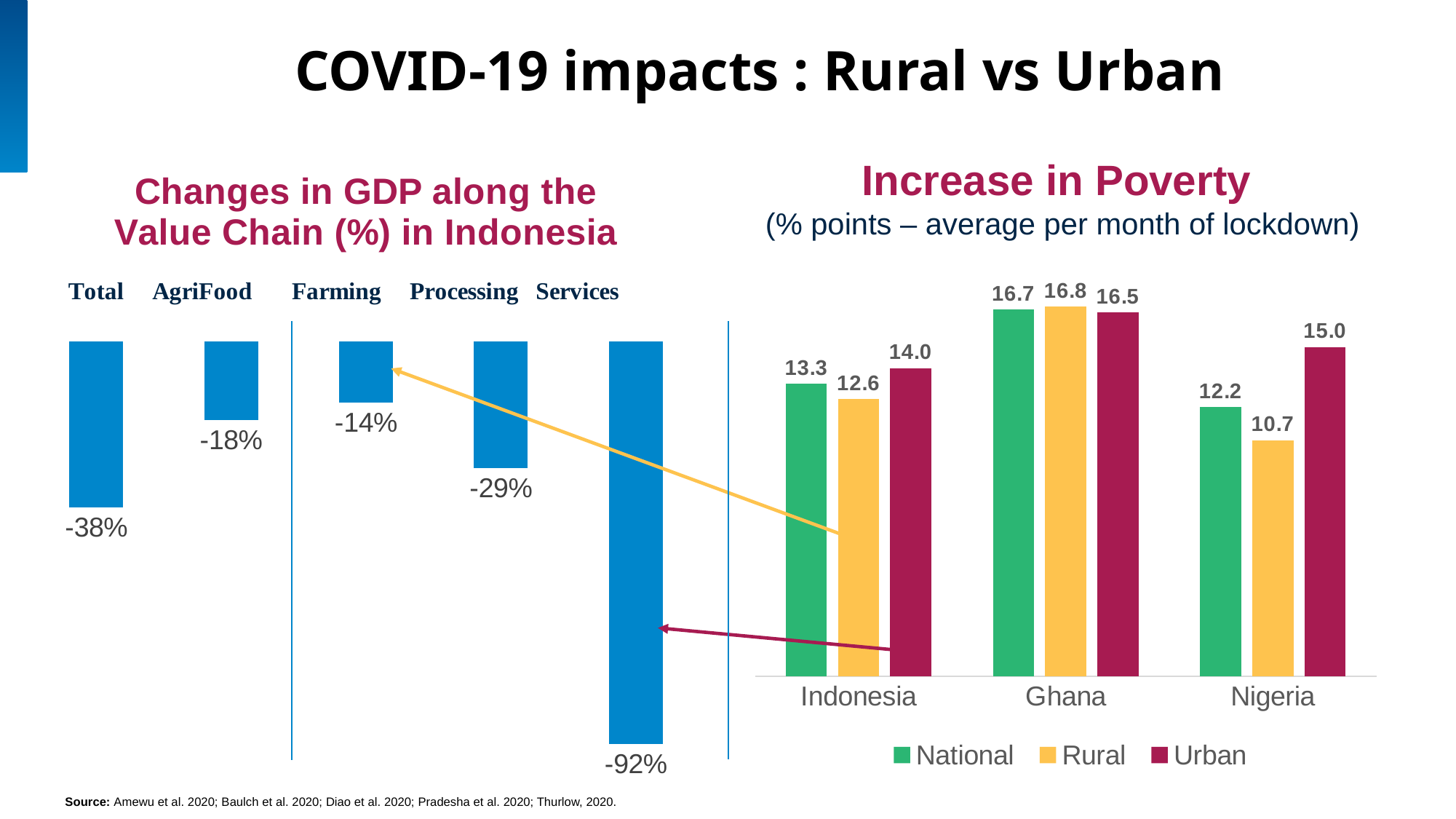
In the 'Increase in Poverty' chart, is the National value for Indonesia or Ghana larger? Ghana In the 'Increase in Poverty' chart, what is the Urban value for Indonesia? 14.0 How many series does the legend of the 'Increase in Poverty' chart list? 3 In the 'Increase in Poverty' chart, which country has the highest Rural value? Ghana In the 'Increase in Poverty' chart, what is the Rural value for Nigeria? 10.7 In the 'Increase in Poverty' chart, what is the difference between the Urban and Rural values for Nigeria? 4.3 In the 'Changes in GDP along the Value Chain (%) in Indonesia' chart, what is the value for Services? -92% In the 'Changes in GDP along the Value Chain (%) in Indonesia' chart, which category has the smallest decline? Farming In the 'Changes in GDP along the Value Chain (%) in Indonesia' chart, how many categories are shown? 5 In the 'Changes in GDP along the Value Chain (%) in Indonesia' chart, what is the value for Total? -38% What kind of chart is the 'Changes in GDP along the Value Chain (%) in Indonesia' chart? Bar chart In the 'Changes in GDP along the Value Chain (%) in Indonesia' chart, which category has the largest decline? Services